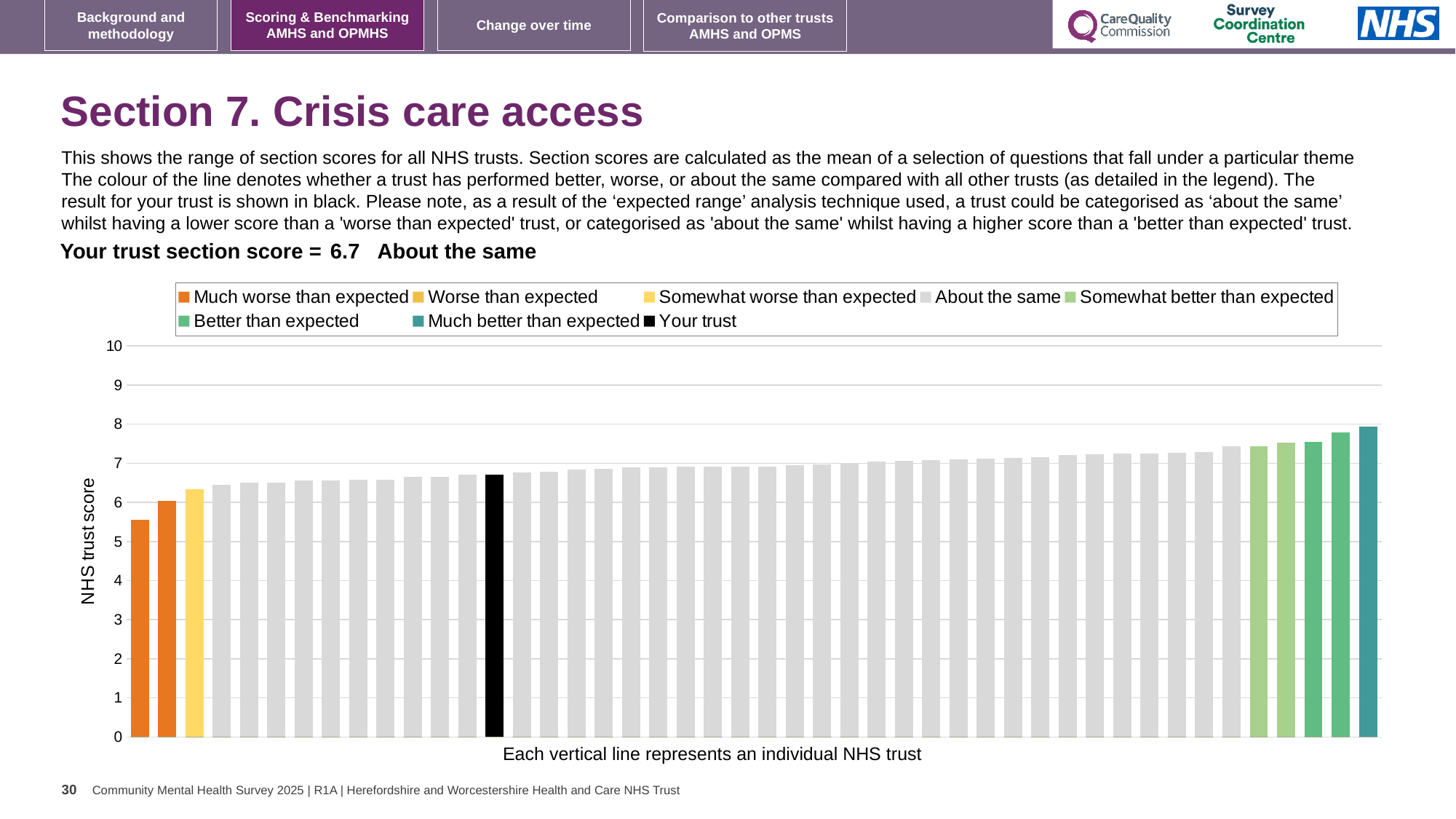
Is the value for your trust (the black bar) greater or less than 6? greater How many bars are coloured orange (Much worse than expected)? 2 Which category is your trust placed in for this section? About the same Do the bar values rise or fall from left to right along the x axis? rise Is the bar for your trust higher or lower than the leftmost bar? higher What is the section score for your trust? 6.7 What kind of chart is shown on the slide? bar chart Is the value of the tallest bar greater or less than 8? less Is the value of the rightmost bar greater or less than 7? greater How many entries does the legend list? 8 What is the title of the vertical axis? NHS trust score